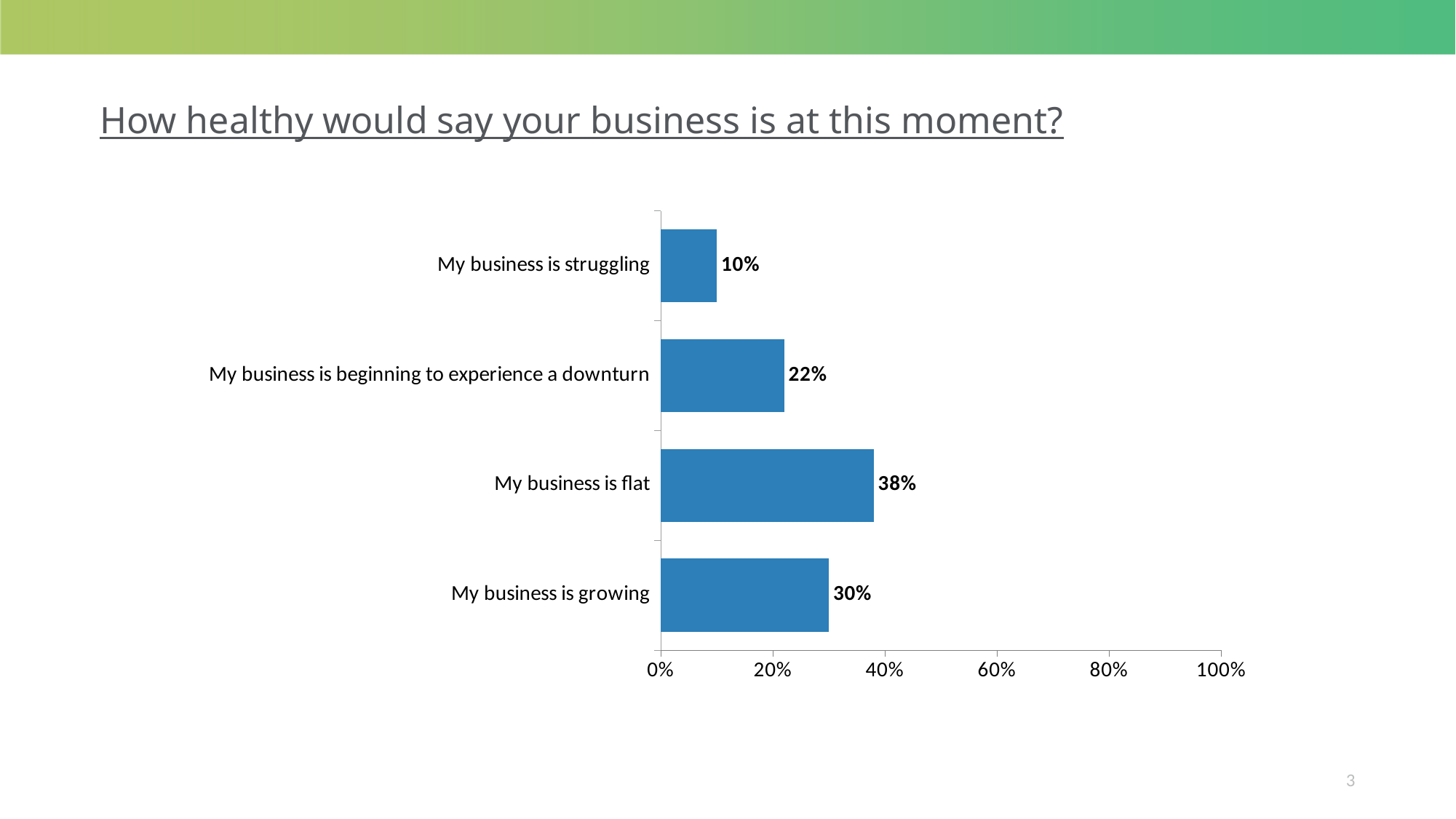
What percentage of respondents said "My business is struggling"? 10% What percentage of respondents said "My business is flat"? 38% Is the value for "My business is flat" greater or less than 40%? less What is the difference in percentage points between "My business is beginning to experience a downturn" and "My business is struggling"? 12 Which category has the lowest percentage? My business is struggling What percentage of respondents said "My business is growing"? 30% What is the difference in percentage points between "My business is flat" and "My business is growing"? 8 What percentage of respondents said "My business is beginning to experience a downturn"? 22% How many categories are shown in the chart? 4 Which category has the highest percentage? My business is flat Which is larger: the value for "My business is growing" or the value for "My business is beginning to experience a downturn"? My business is growing What type of chart is shown on the slide? Bar chart